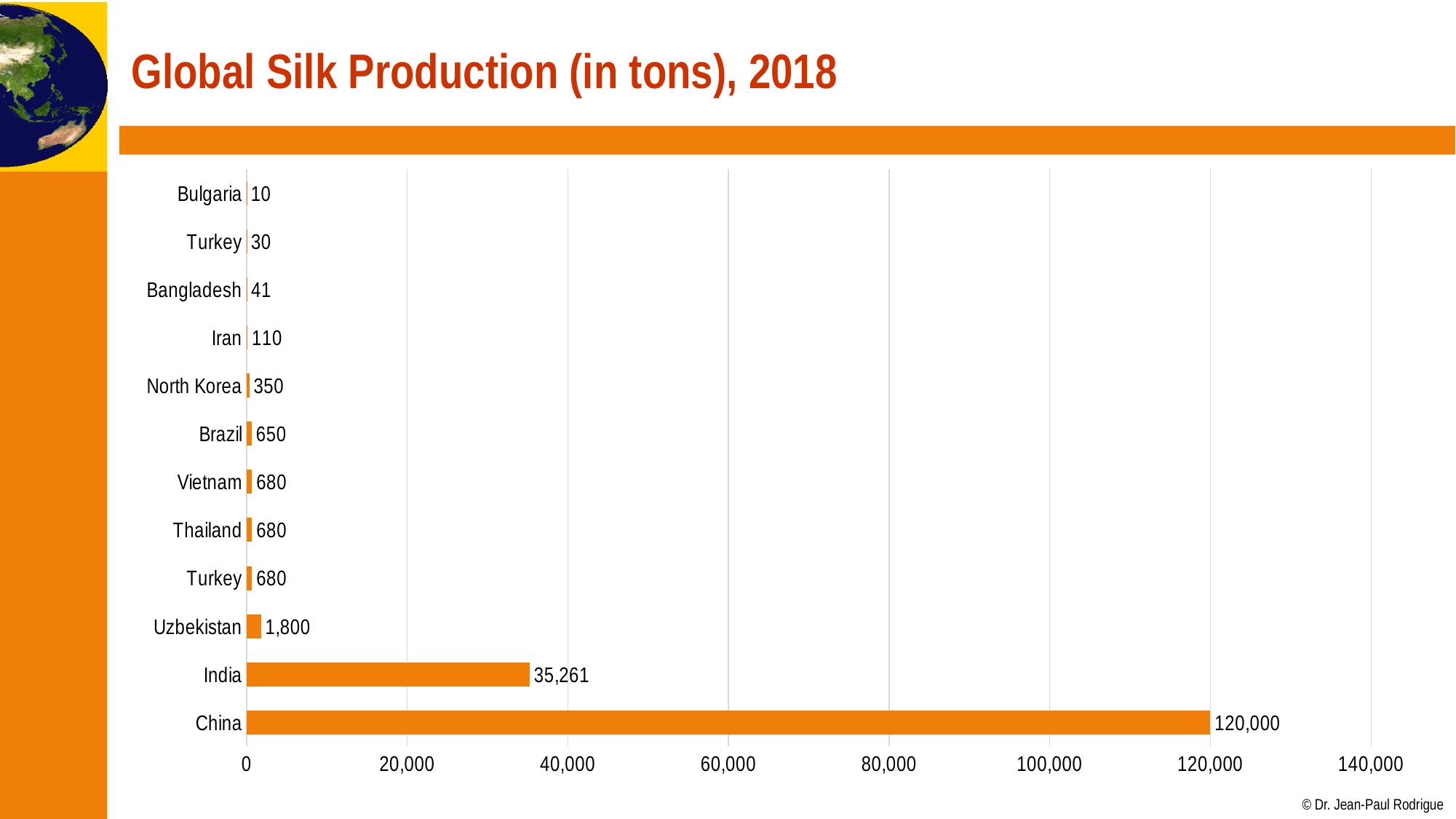
What is the silk production value shown for China? 120,000 What is the silk production value shown for India? 35,261 What is the silk production value shown for North Korea? 350 Is the value for India greater or less than 40,000? less Which has a larger silk production value, Brazil or Iran? Brazil Which country has the lowest silk production on the chart? Bulgaria What kind of chart is shown on the slide? Bar chart What is the title of the slide? Global Silk Production (in tons), 2018 What is the difference between China's and India's silk production values? 84,739 Which country has the highest silk production on the chart? China What is the silk production value shown for Uzbekistan? 1,800 How many bars (countries) are shown on the chart? 12